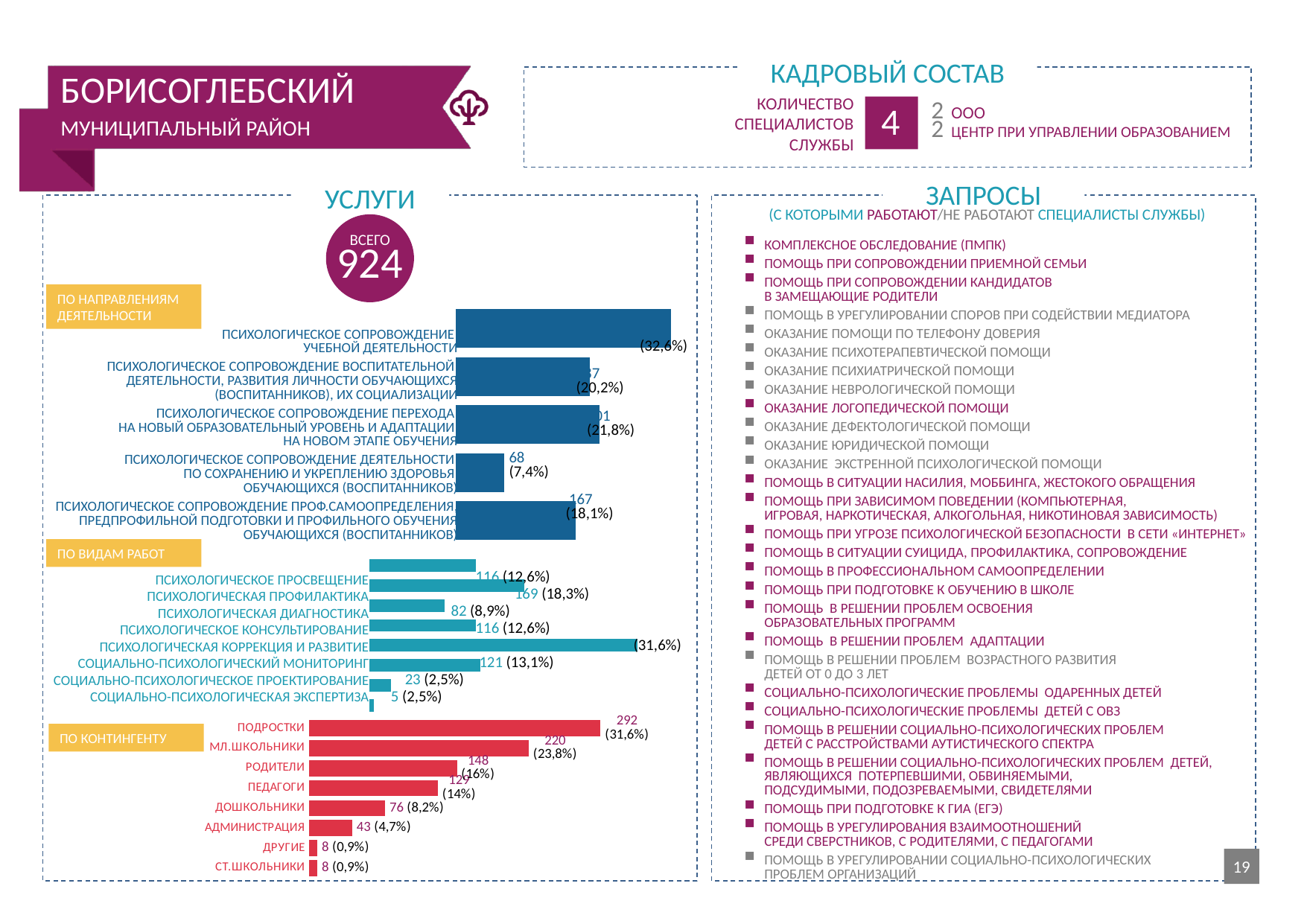
What total number of services (ВСЕГО) is shown in the УСЛУГИ section? 924 In the "ПО КОНТИНГЕНТУ" chart, what is the value for ПОДРОСТКИ? 292 (31,6%) In the "ПО КОНТИНГЕНТУ" chart, what is the difference between МЛ.ШКОЛЬНИКИ and РОДИТЕЛИ? 72 In the "ПО КОНТИНГЕНТУ" chart, how many categories are shown? 8 In the "ПО ВИДАМ РАБОТ" chart, what is the value for ПСИХОЛОГИЧЕСКАЯ ПРОФИЛАКТИКА? 169 (18,3%) In the "ПО ВИДАМ РАБОТ" chart, which category has the highest value? ПСИХОЛОГИЧЕСКАЯ КОРРЕКЦИЯ И РАЗВИТИЕ In the "ПО НАПРАВЛЕНИЯМ ДЕЯТЕЛЬНОСТИ" chart, what percentage is shown for психологическое сопровождение учебной деятельности? 32,6% In the "ПО КОНТИНГЕНТУ" chart, which category has the highest value? ПОДРОСТКИ What type of chart is used in the "ПО КОНТИНГЕНТУ" section? Bar chart In the "ПО НАПРАВЛЕНИЯМ ДЕЯТЕЛЬНОСТИ" chart, what is the value for психологическое сопровождение деятельности по сохранению и укреплению здоровья обучающихся? 68 (7,4%) In the "ПО ВИДАМ РАБОТ" chart, which category has the lowest value? СОЦИАЛЬНО-ПСИХОЛОГИЧЕСКАЯ ЭКСПЕРТИЗА In the "ПО ВИДАМ РАБОТ" chart, which is larger: СОЦИАЛЬНО-ПСИХОЛОГИЧЕСКИЙ МОНИТОРИНГ or ПСИХОЛОГИЧЕСКАЯ ДИАГНОСТИКА? СОЦИАЛЬНО-ПСИХОЛОГИЧЕСКИЙ МОНИТОРИНГ